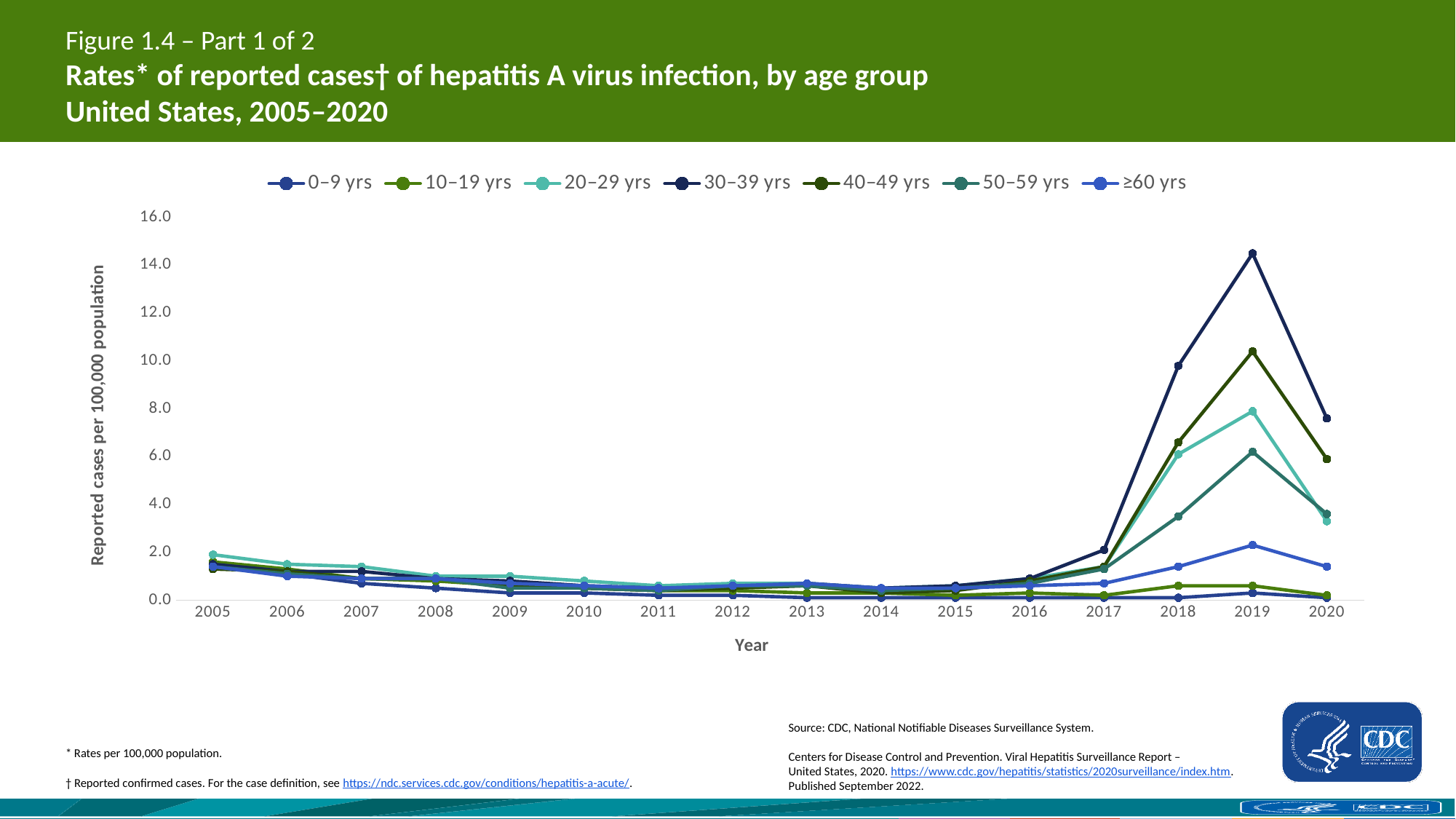
What is the label on the y axis? Reported cases per 100,000 population Is the value for ≥60 yrs in 2019 greater or less than 4.0? less Does the rate for 30–39 yrs rise or fall from 2017 to 2019? rise Is the value for 30–39 yrs in 2019 greater or less than 12.0? greater How many years are plotted along the x axis? 16 How many age-group series does the legend list? 7 Which age group has the highest rate in 2019? 30–39 yrs What kind of chart is shown on the slide? line chart Which age group has the lowest rate in 2018? 0–9 yrs Is the value for 40–49 yrs in 2019 greater or less than 8.0? greater Does the rate for 30–39 yrs rise or fall from 2019 to 2020? fall In 2020, which is larger: the rate for 40–49 yrs or the rate for 50–59 yrs? 40–49 yrs